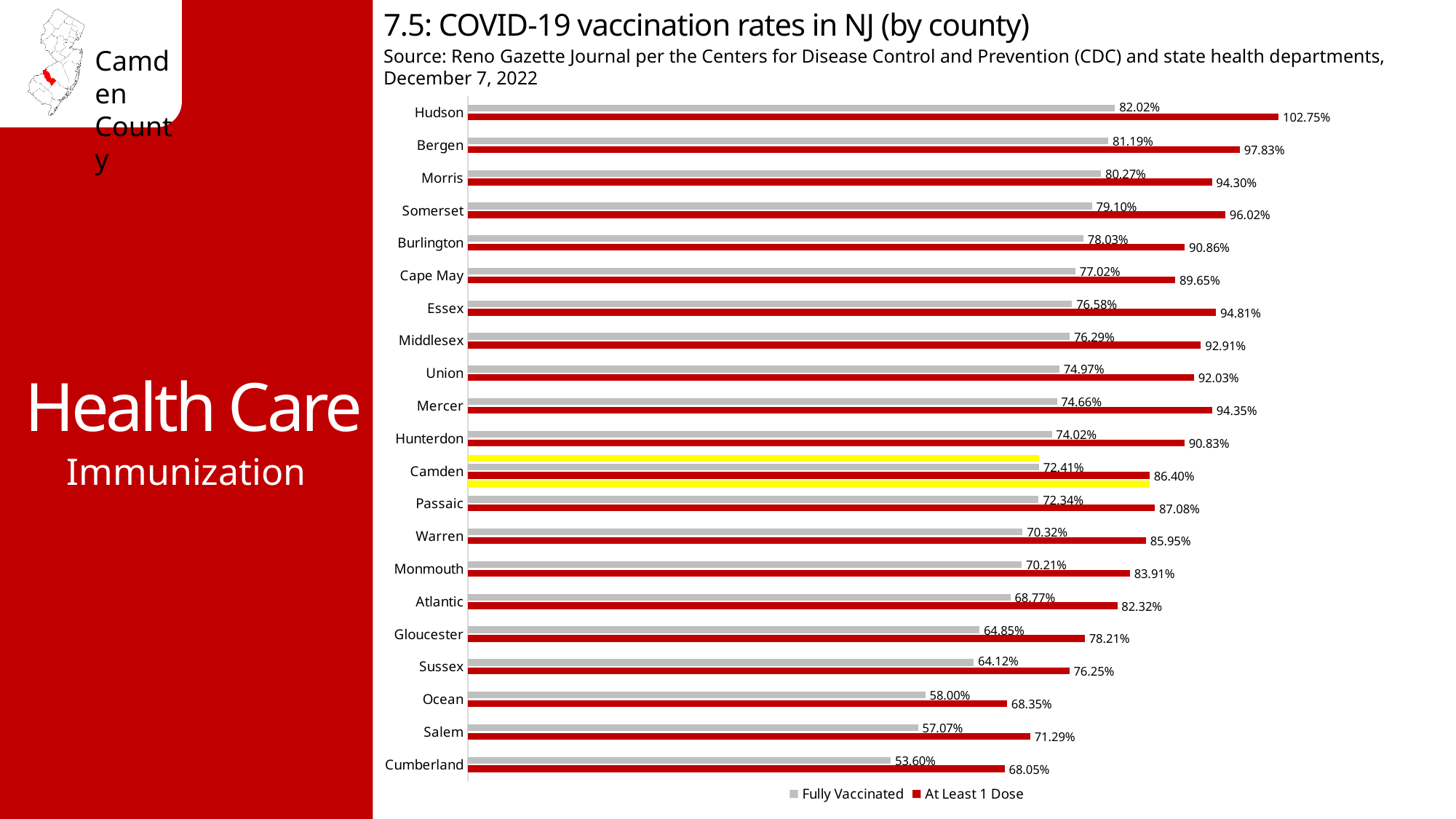
What is the At Least 1 Dose rate for Hudson? 102.75% Which county has the highest Fully Vaccinated rate? Hudson How many series does the legend list? 2 What is the difference between the At Least 1 Dose rate and the Fully Vaccinated rate for Camden? 13.99% How many counties are shown in the chart? 21 Which county has the lowest Fully Vaccinated rate? Cumberland Which county has a higher At Least 1 Dose rate, Essex or Middlesex? Essex Which county has a higher Fully Vaccinated rate, Ocean or Salem? Ocean What type of chart is shown on the slide? Bar chart Which county has the lowest At Least 1 Dose rate? Cumberland What is the Fully Vaccinated rate for Camden? 72.41% What is the At Least 1 Dose rate for Gloucester? 78.21%